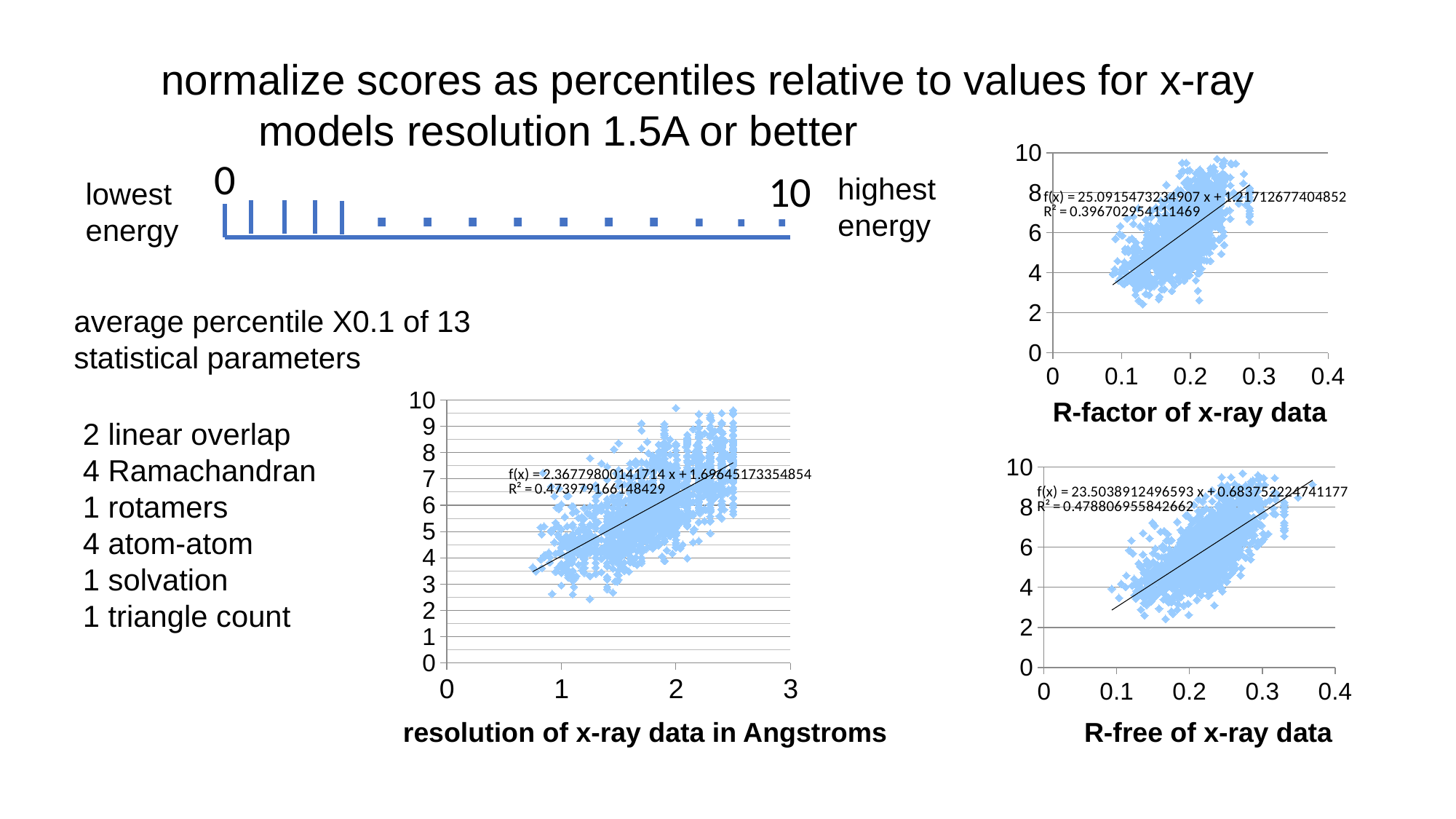
In the chart labelled 'R-free of x-ray data', what is the R² value printed for the trendline? 0.478806955842662 What kind of chart is the chart labelled 'resolution of x-ray data in Angstroms'? scatter chart In the chart labelled 'R-free of x-ray data', do the plotted values rise or fall as the x-axis value increases? rise How many scatter charts are shown on the slide? 3 In the chart labelled 'R-factor of x-ray data', what is the R² value printed for the trendline? 0.396702954111469 In the chart labelled 'resolution of x-ray data in Angstroms', what is the R² value printed for the trendline? 0.473979166148429 In the chart labelled 'R-free of x-ray data', what is the trendline equation printed on the chart? f(x) = 23.5038912496593 x + 0.683752224741177 Which chart has the higher printed R² value, 'R-factor of x-ray data' or 'R-free of x-ray data'? R-free of x-ray data In the chart labelled 'R-factor of x-ray data', do the plotted values rise or fall as the x-axis value increases? rise In the chart labelled 'R-factor of x-ray data', what is the maximum value shown on the y axis? 10 In the chart labelled 'resolution of x-ray data in Angstroms', what is the maximum value shown on the x axis? 3 In the chart labelled 'R-factor of x-ray data', what is the trendline equation printed on the chart? f(x) = 25.0915473234907 x + 1.21712677404852